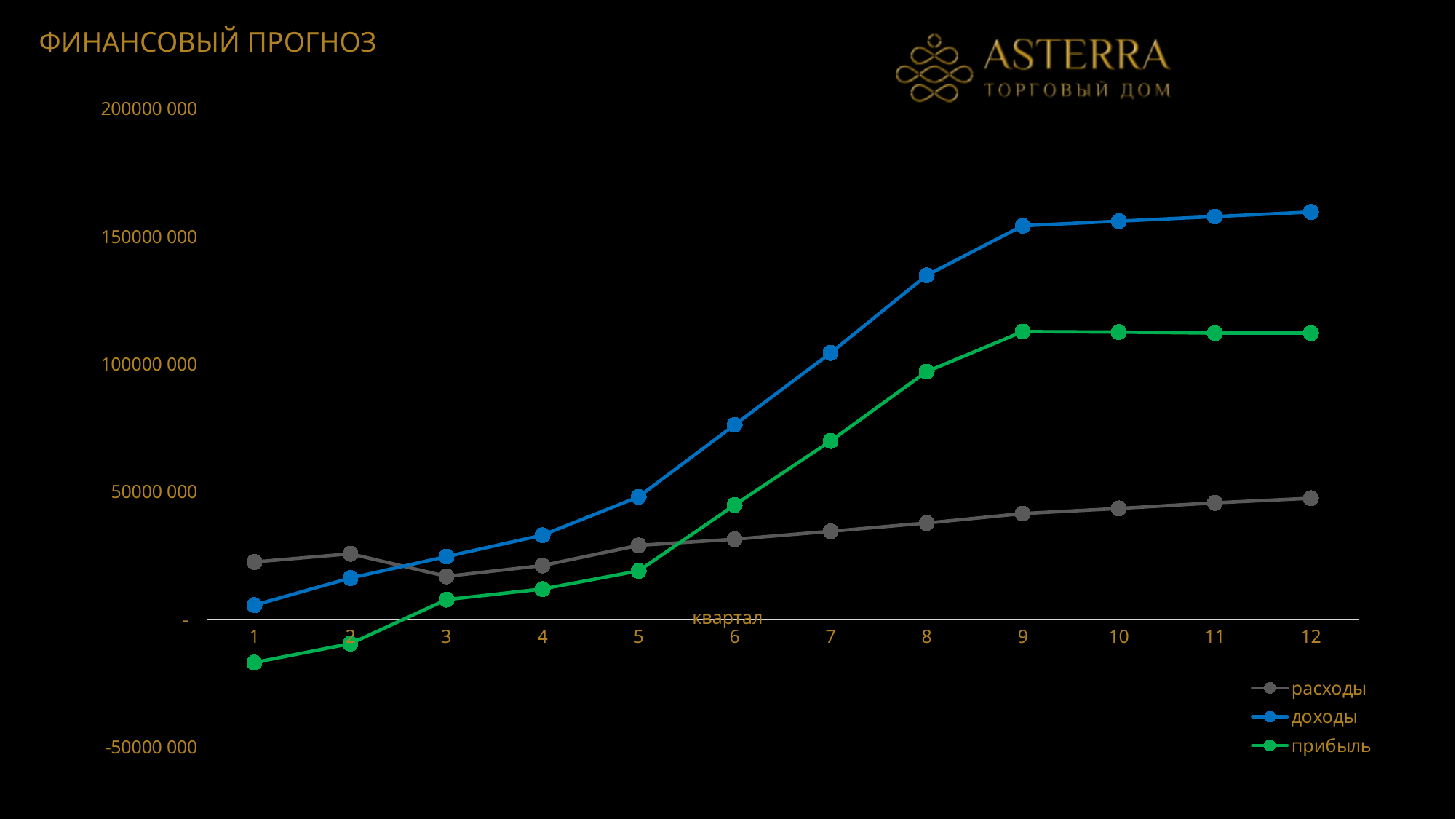
In quarter 1, which is larger: расходы or доходы? расходы Is the value for расходы in quarter 6 greater or less than 50000 000? less Is the value for прибыль in quarter 9 greater or less than 100000 000? greater How many quarters are plotted along the x axis? 12 How many series does the legend list? 3 What kind of chart is shown on the slide? line chart Does the доходы series rise or fall from quarter 1 to quarter 12? rises Which series has the highest value in quarter 12? доходы Which series is drawn in green according to the legend? прибыль What is the title of the chart? ФИНАНСОВЫЙ ПРОГНОЗ Is the value for доходы in quarter 8 greater or less than 100000 000? greater